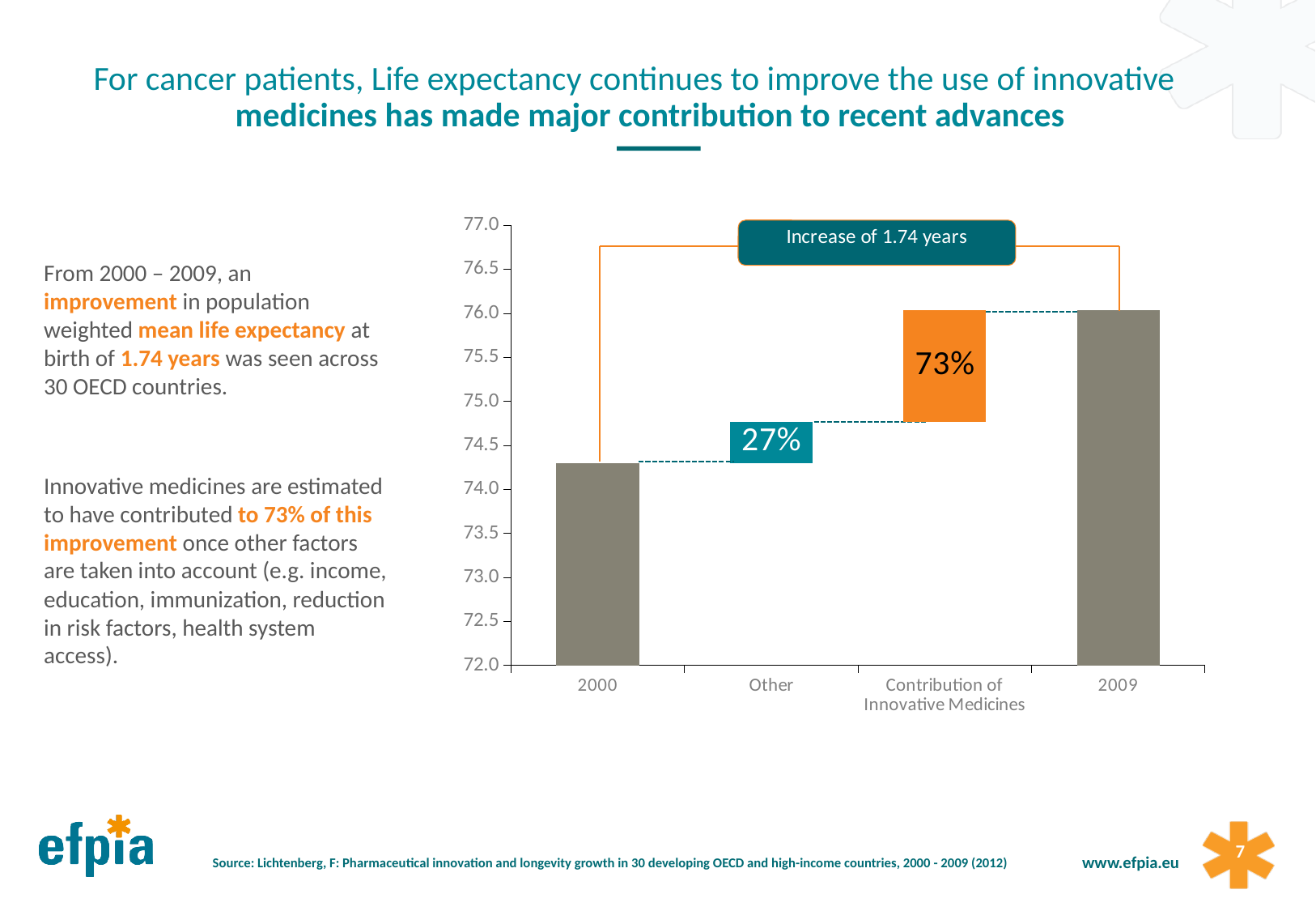
According to the annotation on the chart, what is the total increase in life expectancy between 2000 and 2009? 1.74 years What percentage label is shown on the 'Contribution of Innovative Medicines' bar? 73% Which has the larger share of the improvement: 'Other' or 'Contribution of Innovative Medicines'? Contribution of Innovative Medicines What kind of chart is shown on the slide? bar chart What colour is the 'Contribution of Innovative Medicines' bar? orange Does life expectancy rise or fall from 2000 to 2009 in the chart? rise Which bar is taller: 2000 or 2009? 2009 What is the difference in percentage points between the 'Contribution of Innovative Medicines' label and the 'Other' label? 46 percentage points Is the value for 2009 greater or less than 75.5? greater Is the value for 2000 greater or less than 74.5? less What percentage label is shown on the 'Other' bar? 27% How many categories are shown on the x axis of the chart? 4